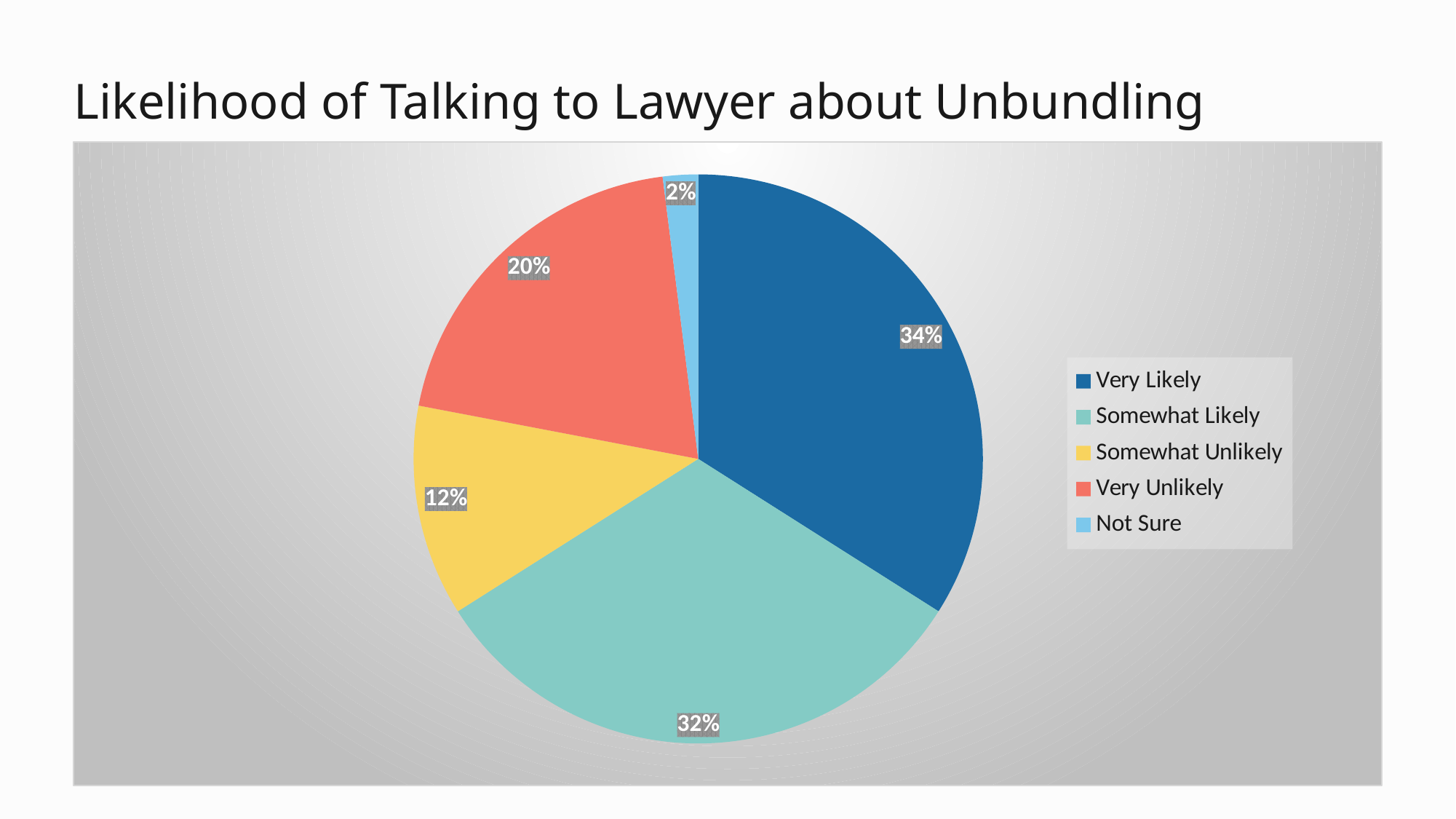
Which category has the smallest share of the pie? Not Sure Which category has the largest share of the pie? Very Likely What percentage of respondents are Not Sure? 2% Which is larger, the share for Somewhat Likely or the share for Very Unlikely? Somewhat Likely What type of chart is shown on the slide? Pie chart What percentage of respondents are Very Likely to talk to a lawyer about unbundling? 34% What percentage of respondents are Somewhat Unlikely? 12% What is the difference in percentage points between Very Unlikely and Somewhat Unlikely? 8 What percentage of respondents are Somewhat Likely? 32% What is the title of the chart? Likelihood of Talking to Lawyer about Unbundling How many categories does the legend list? 5 What percentage of respondents are Very Unlikely? 20%